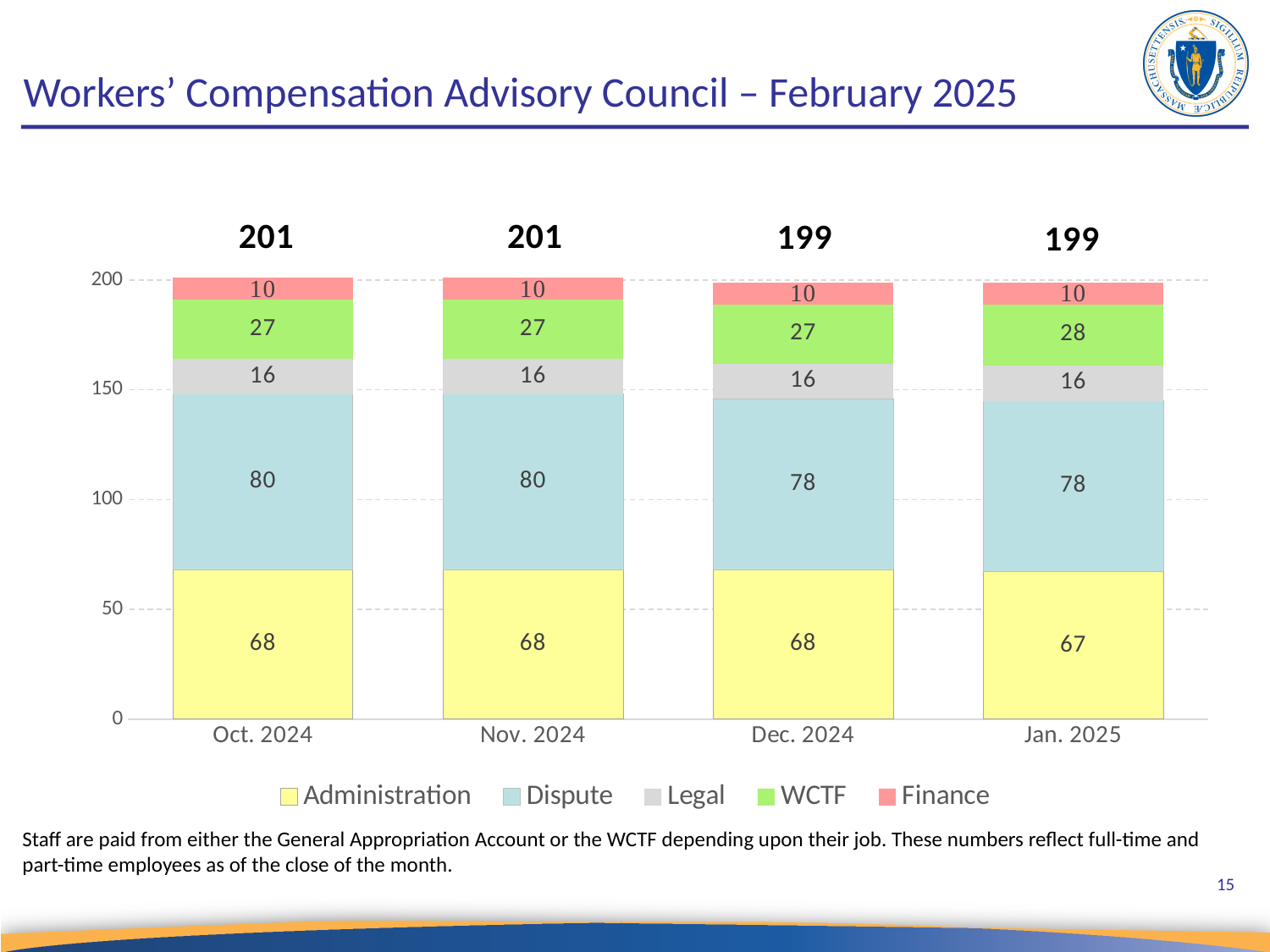
How many months are shown on the x axis? 4 What is the difference between the Dispute values for Nov. 2024 and Dec. 2024? 2 What is the Dispute value for Oct. 2024? 80 What is the Legal value for Dec. 2024? 16 What is the Administration value for Jan. 2025? 67 What kind of chart is shown on the slide? Stacked bar chart How many series does the legend list? 5 Which is larger, the Administration value for Oct. 2024 or the Administration value for Jan. 2025? Oct. 2024 What is the WCTF value for Jan. 2025? 28 What is the total of the stacked bar for Dec. 2024? 199 What is the total of the stacked bar for Nov. 2024? 201 Which series is shown in yellow in the legend? Administration